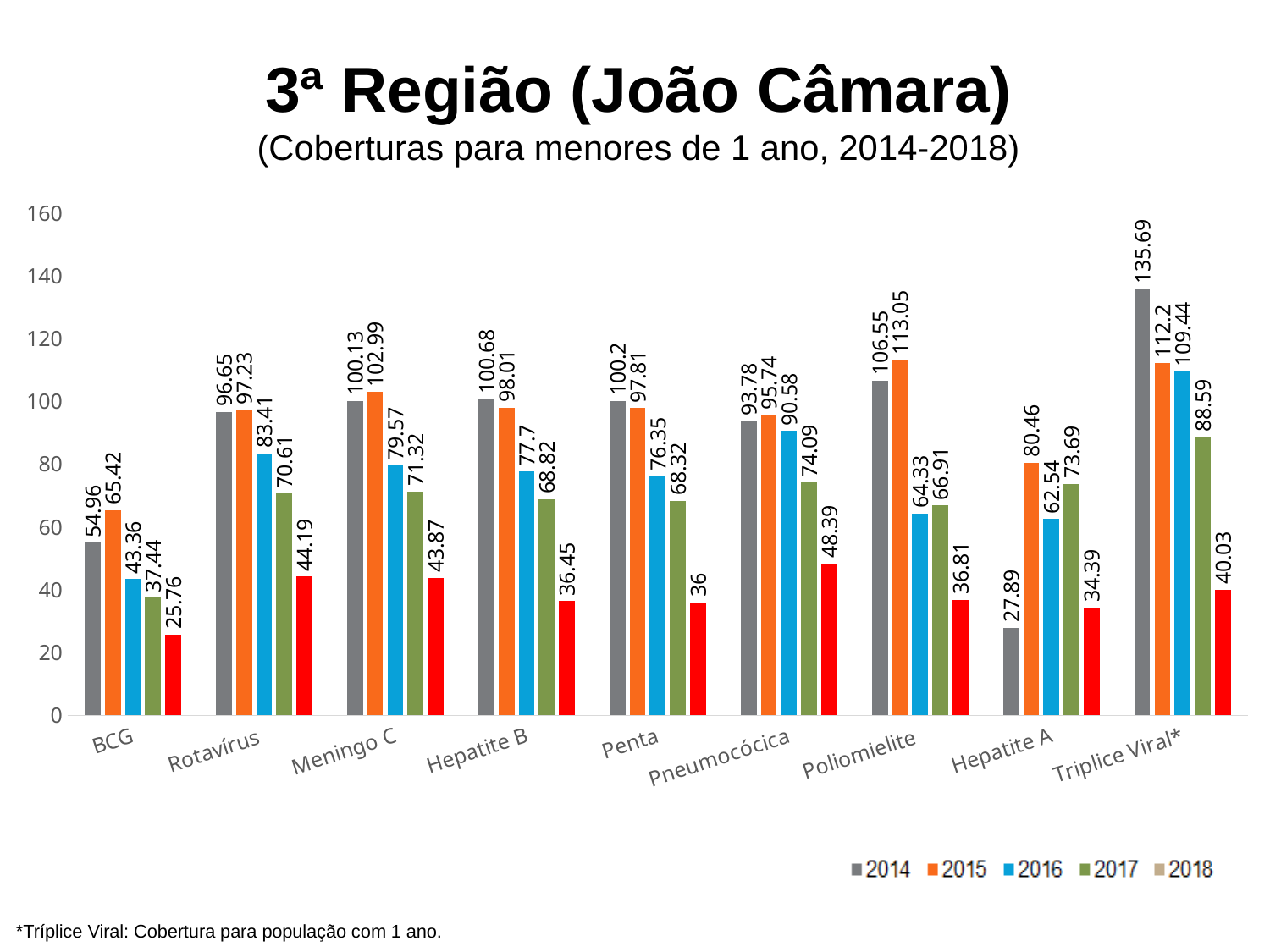
What is the value for BCG in 2014? 54.96 For Hepatite A, which year has the larger value, 2015 or 2017? 2015 Which category has the highest value for 2014? Tríplice Viral* Which category has the lowest value for 2018? BCG What is the difference between the 2014 and 2018 values for Tríplice Viral*? 95.66 Do the values for BCG rise or fall from 2014 to 2018? Fall What is the value for Poliomielite in 2015? 113.05 How many categories are shown on the x axis? 9 What is the value for Penta in 2018? 36 What is the difference between the 2015 and 2014 values for Poliomielite? 6.5 What kind of chart is shown on the slide? Bar chart How many series does the legend list? 5